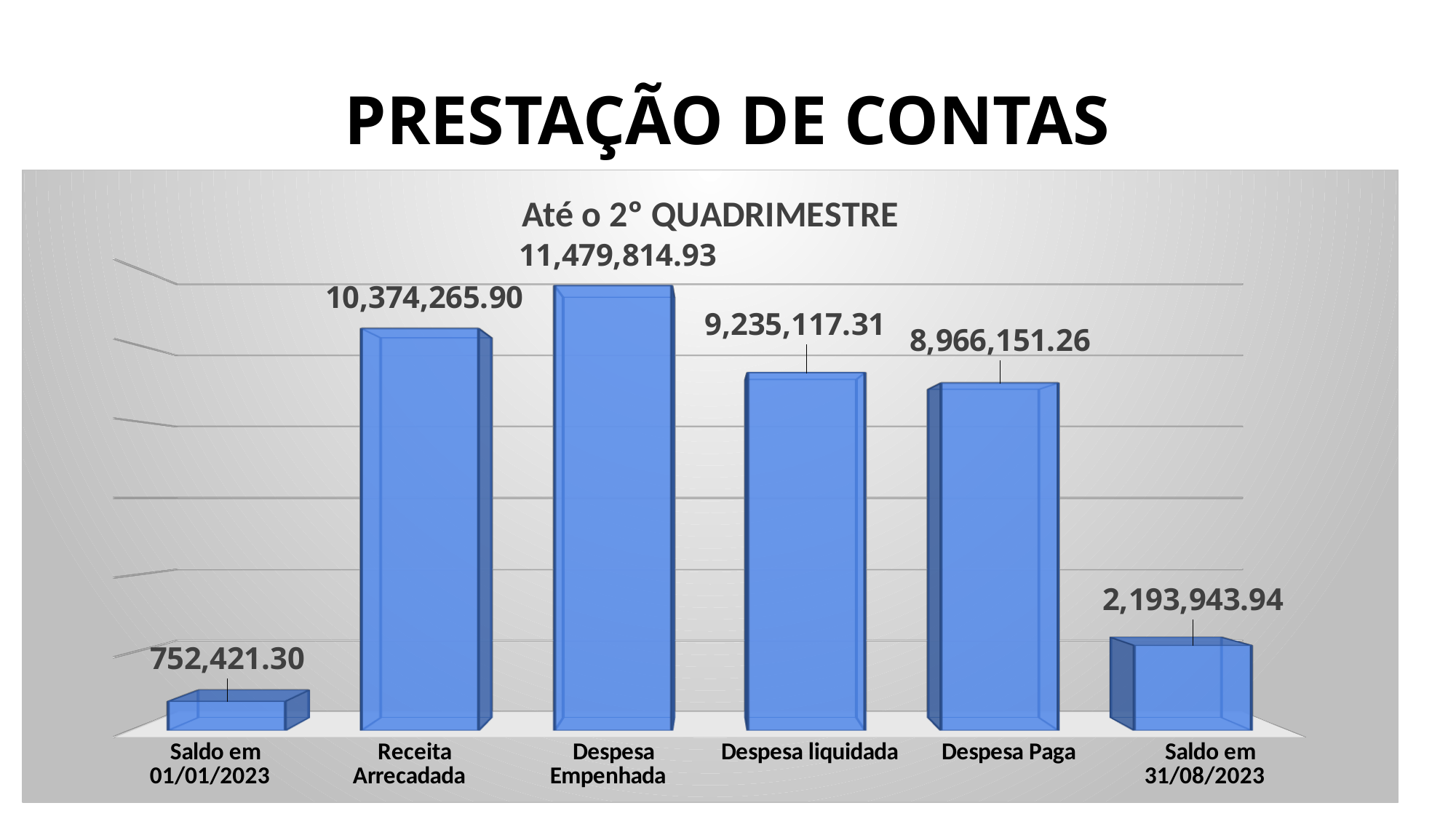
What is the value for Saldo em 01/01/2023? 752,421.30 Which category has the highest value? Despesa Empenhada Which category has the lowest value? Saldo em 01/01/2023 What kind of chart is shown on the slide? Bar chart What is the difference between Despesa Empenhada and Receita Arrecadada? 1,105,549.03 What is the difference between Despesa liquidada and Despesa Paga? 268,966.05 What is the title of the chart? Até o 2° QUADRIMESTRE What is the value for Receita Arrecadada? 10,374,265.90 What is the value for Saldo em 31/08/2023? 2,193,943.94 How many categories are shown in the chart? 6 What is the value for Despesa Paga? 8,966,151.26 Which is larger, Despesa liquidada or Despesa Paga? Despesa liquidada